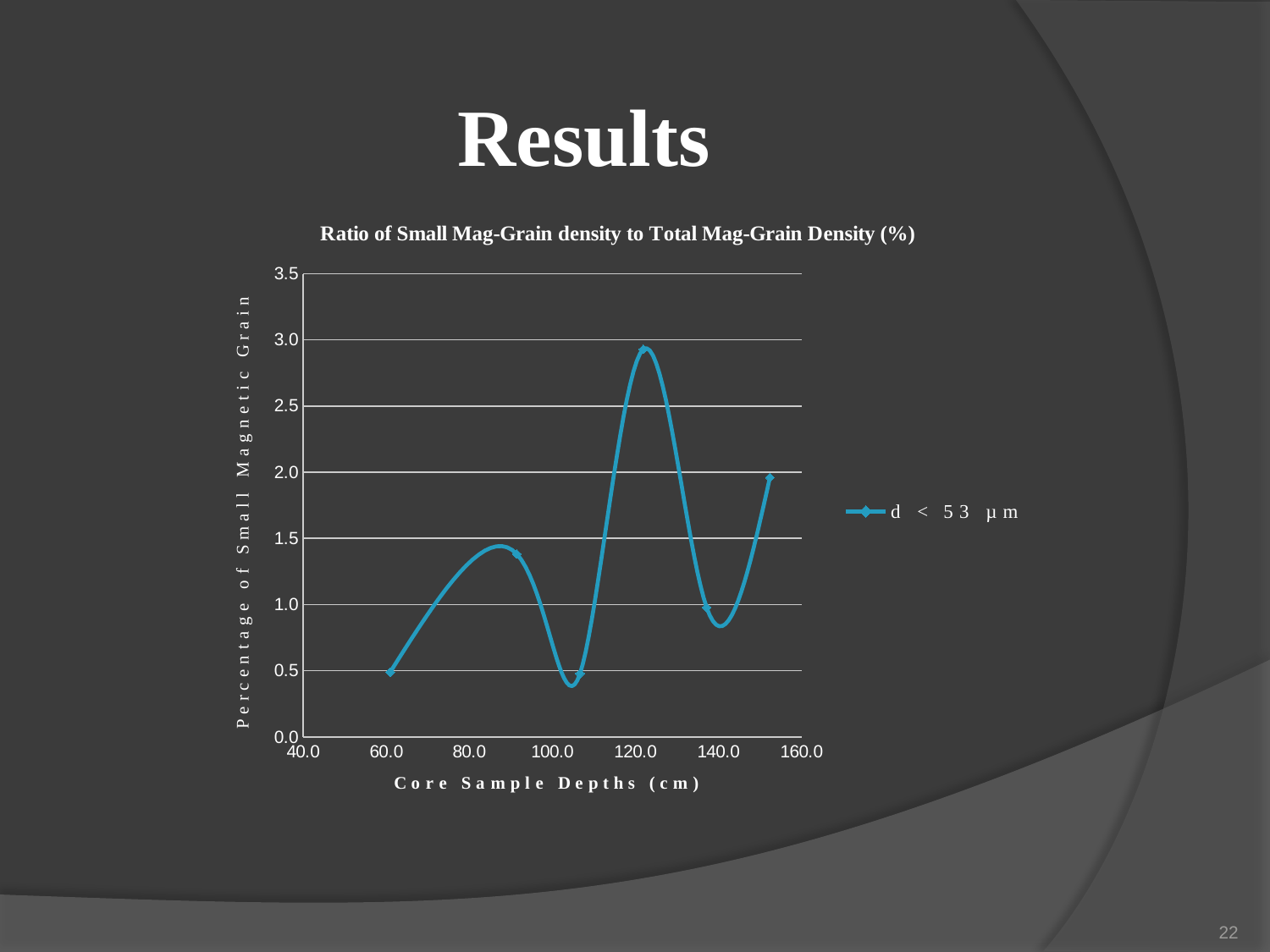
Is the value at the peak near a depth of 120 cm greater or less than 2.5? greater Between the first data point near 60 cm and the second near 90 cm, does the line rise or fall? rise Is the value at the last data point, near a depth of 150 cm, greater or less than 1.5? greater What kind of chart is shown on the slide? line chart Is the value at the dip near a depth of 105 cm greater or less than 1.0? less How many series does the legend list? 1 What is the title of the chart? Ratio of Small Mag-Grain density to Total Mag-Grain Density (%) Which is larger: the value at the peak near 120 cm or the value at the last point near 150 cm? the peak near 120 cm How many data points are plotted on the line? 6 What is the legend entry for the plotted series? d < 53 µm